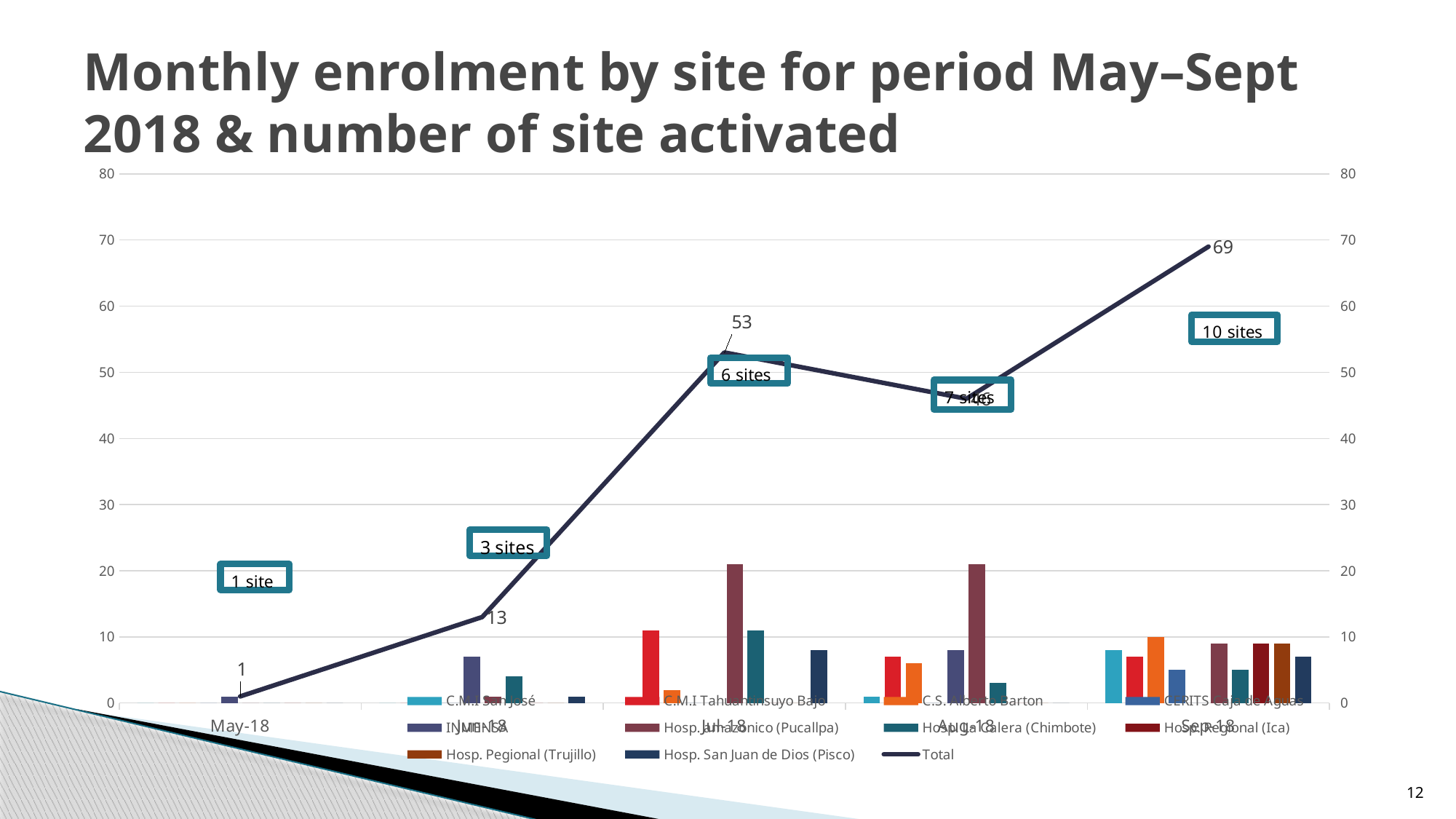
How many sites were activated by Sep-18 according to the label on the chart? 10 sites Is the Total enrolment for Jul-18 or Aug-18 larger? Jul-18 What is the Total enrolment value for May-18? 1 Which month has the highest Total enrolment? Sep-18 How many months are shown on the x axis? 5 What is the difference between the Total enrolment in Sep-18 and Jul-18? 16 What is the Total enrolment value for Jun-18? 13 Is the Total enrolment for Aug-18 greater or less than 40? greater How many series does the legend list? 11 Which month has the lowest Total enrolment? May-18 What is the Total enrolment value for Jul-18? 53 What is the Total enrolment value for Sep-18? 69